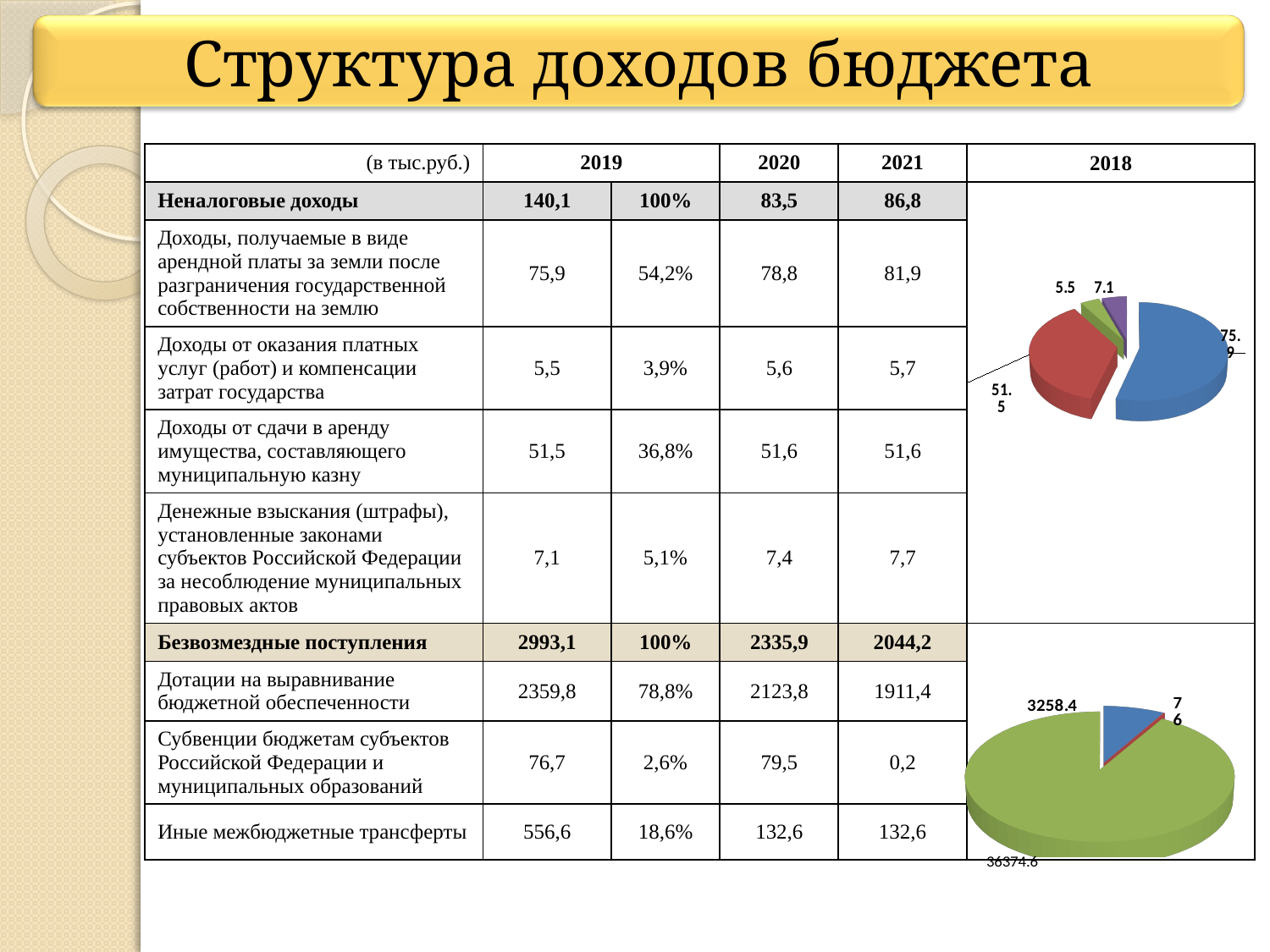
In the upper pie chart in the 2018 column, what is the difference between the two largest slice values, 75.9 and 51.5? 24.4 In the lower pie chart in the 2018 column, what is the value of the largest slice? 36374.6 In the upper pie chart in the 2018 column, what is the value of the smallest slice? 5.5 What kind of chart is the lower chart in the 2018 column? pie chart In the upper pie chart in the 2018 column, what is the value of the largest slice? 75.9 What colour is the largest slice in the upper pie chart in the 2018 column? blue What kind of chart is the upper chart in the 2018 column? pie chart How many slices does the lower pie chart in the 2018 column have? 3 How many slices does the upper pie chart in the 2018 column have? 4 Which year do the two pie charts on the slide represent, according to the column header above them? 2018 In the upper pie chart in the 2018 column, which of the two small slices is larger, the one labelled 7.1 or the one labelled 5.5? 7.1 In the lower pie chart in the 2018 column, what is the value of the smallest slice? 76